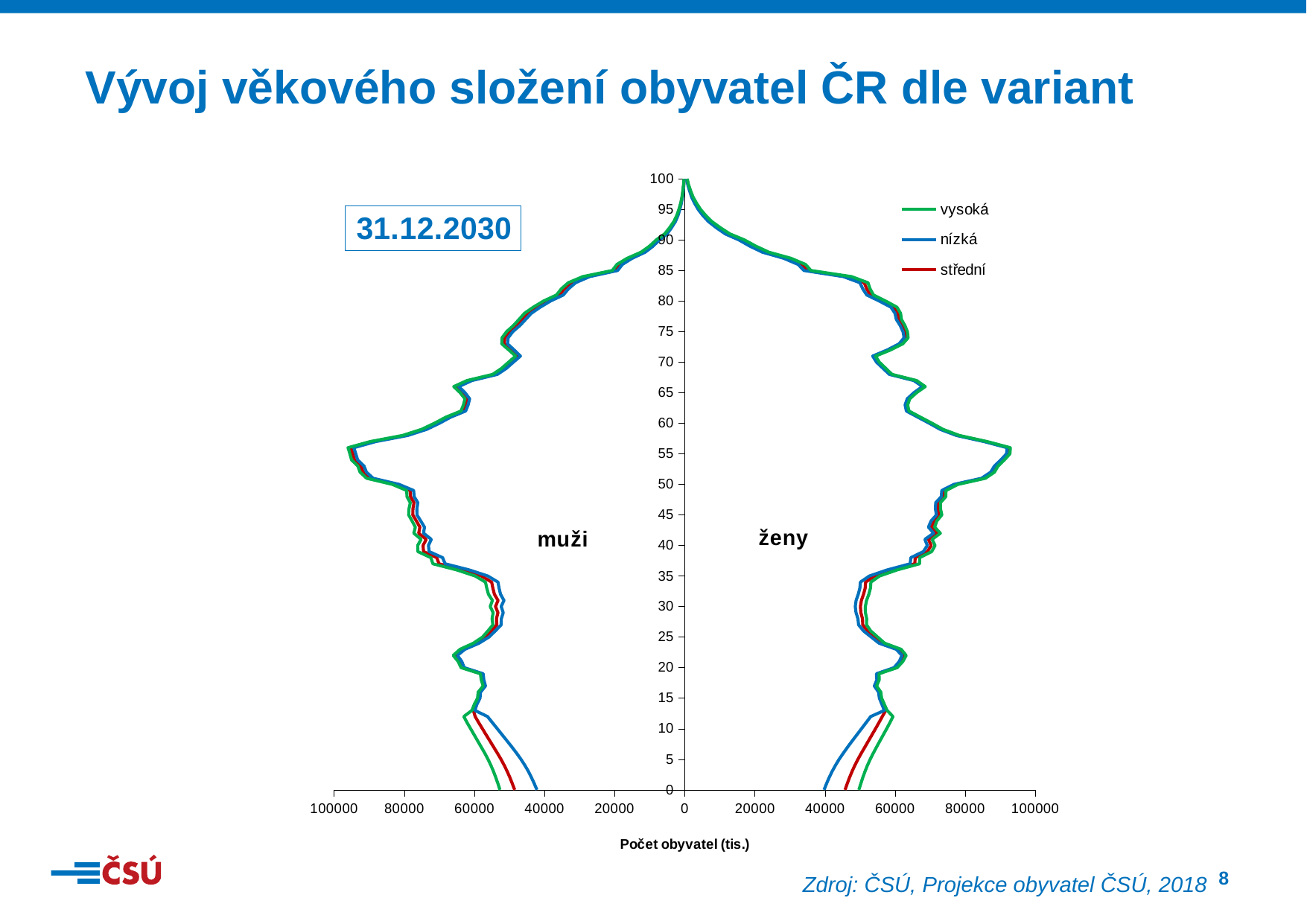
Is the value for men (muži) at age 90 greater or less than 20000? less Is the value for women (ženy) at age 55 greater or less than 80000? greater Is the value for men (muži) at age 0 in the vysoká variant greater or less than 40000? greater What are the three variants listed in the legend? vysoká, nízká, střední What kind of chart is shown on the slide? line chart (population pyramid) Which date is shown in the box on the chart? 31.12.2030 At age 0, which variant gives the highest number of men (muži)? vysoká How many series does the legend list? 3 At age 90, which is larger: the number of men (muži) or the number of women (ženy)? ženy